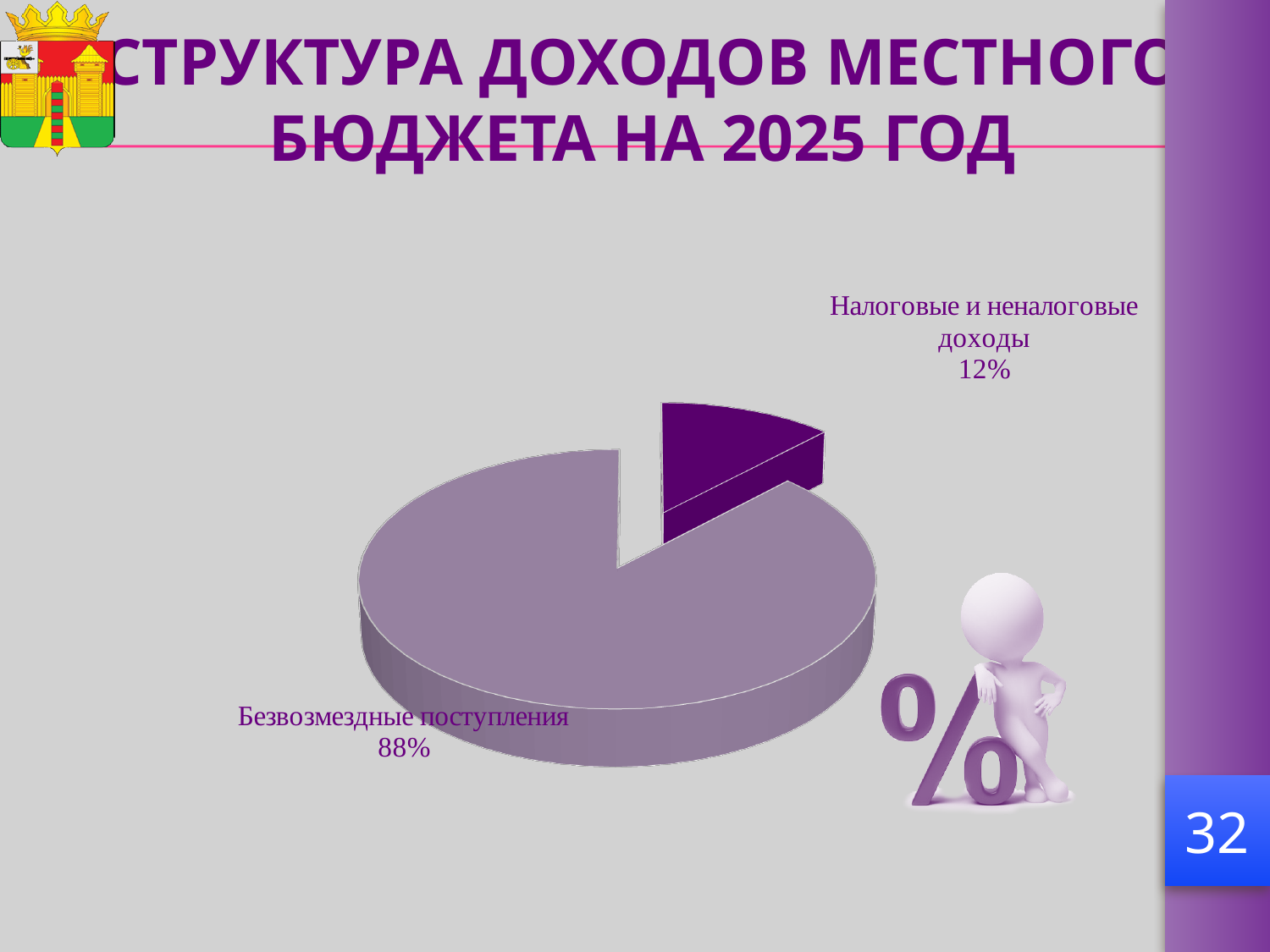
What is the difference in percentage points between Безвозмездные поступления and Налоговые и неналоговые доходы? 76 Which slice is pulled out (exploded) from the pie? Налоговые и неналоговые доходы Which category has the largest slice of the pie? Безвозмездные поступления What share of the pie does Налоговые и неналоговые доходы have? 12% What is the title of the slide containing the chart? СТРУКТУРА ДОХОДОВ МЕСТНОГО БЮДЖЕТА НА 2025 ГОД How many categories are shown in the pie chart? 2 Which is larger: Безвозмездные поступления or Налоговые и неналоговые доходы? Безвозмездные поступления What kind of chart is shown on the slide? Pie chart What share of the pie does Безвозмездные поступления have? 88% Which category has the smallest slice of the pie? Налоговые и неналоговые доходы